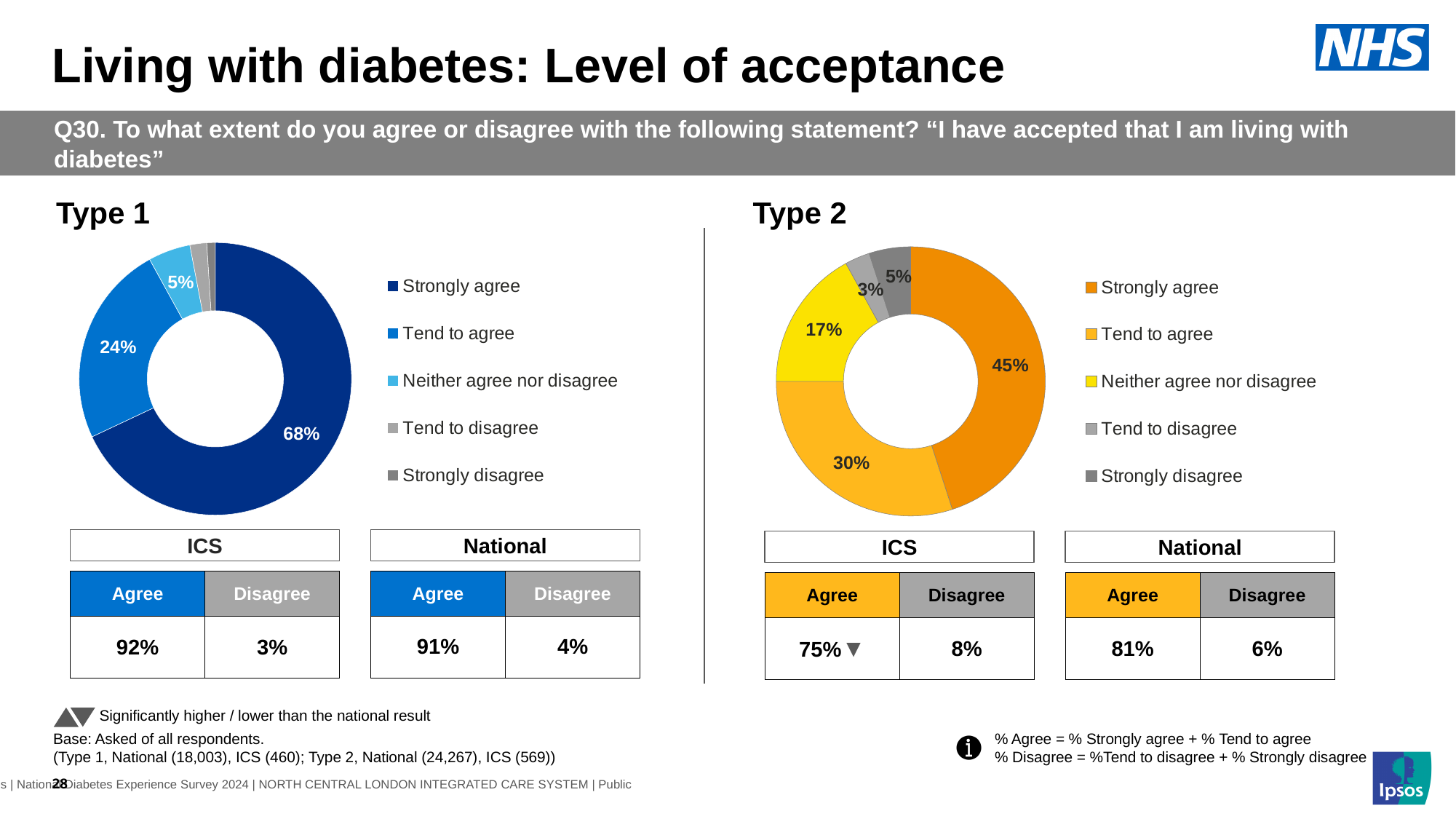
What kind of chart is used for Type 1? Donut chart How many categories does the legend of the Type 2 chart list? 5 In the Type 2 chart, what percentage of respondents strongly agree? 45% In the Type 1 chart, what percentage of respondents strongly agree? 68% In the Type 1 chart, what percentage of respondents tend to agree? 24% In the Type 1 chart, what is the difference between the Strongly agree and Tend to agree shares? 44% In the Type 2 chart, what percentage of respondents neither agree nor disagree? 17% In the Type 2 chart, what percentage of respondents tend to disagree? 3% Which is larger: the Strongly agree share in the Type 1 chart or in the Type 2 chart? Type 1 In the Type 1 chart, which category has the largest share? Strongly agree In the Type 2 chart, what is the difference between the Strongly agree and Tend to agree shares? 15% In the Type 2 chart, which category has the largest share? Strongly agree